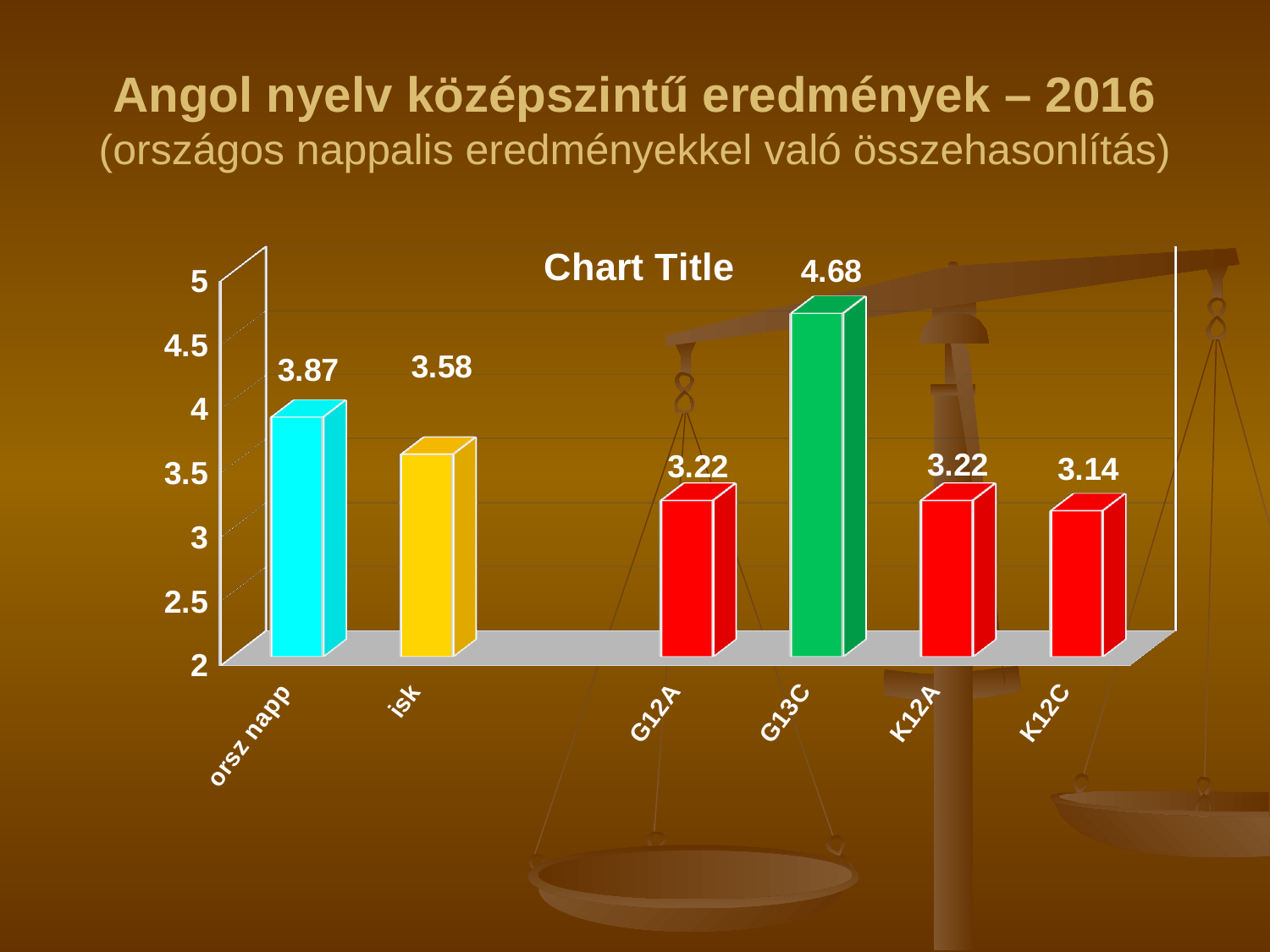
Which is larger, the value for isk or the value for K12A? isk What is the difference between the values for G13C and G12A? 1.46 What is the value for G13C? 4.68 What kind of chart is shown on the slide? bar chart What is the difference between the values for orsz napp and isk? 0.29 Which category has the highest value? G13C How many categories are shown on the chart? 6 What is the value for K12C? 3.14 What is the value for isk? 3.58 What is the value for orsz napp? 3.87 Is the value for G13C greater or less than 4.5? greater Which category has the lowest value? K12C